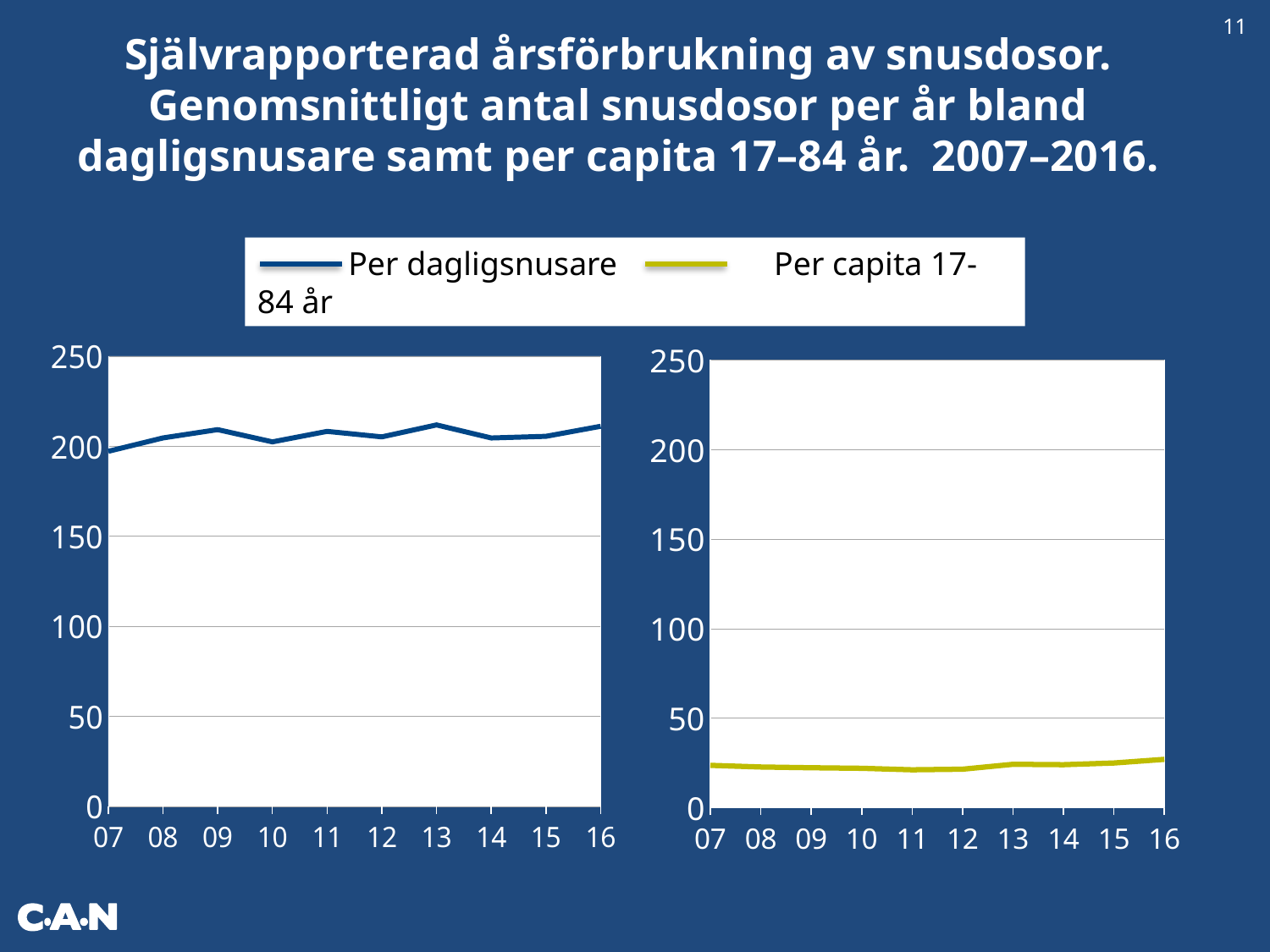
In the right chart (Per capita 17-84 år), does the line rise or fall from 11 to 16? rise In the right chart (Per capita 17-84 år), is the value for 16 greater or less than 50? less How many series does the legend list? 2 What kind of chart is the right chart (Per capita 17-84 år)? line chart What colour is the line for Per capita 17-84 år in the legend? yellow-green How many years are plotted on the x axis of the right chart (Per capita 17-84 år)? 10 In the left chart (Per dagligsnusare), is the value for 13 greater or less than 200? greater In the right chart (Per capita 17-84 år), is the value for 07 greater or less than 50? less How many years are plotted on the x axis of the left chart (Per dagligsnusare)? 10 What kind of chart is the left chart (Per dagligsnusare)? line chart Which is larger for 16: the value in the left chart (Per dagligsnusare) or the value in the right chart (Per capita 17-84 år)? Per dagligsnusare